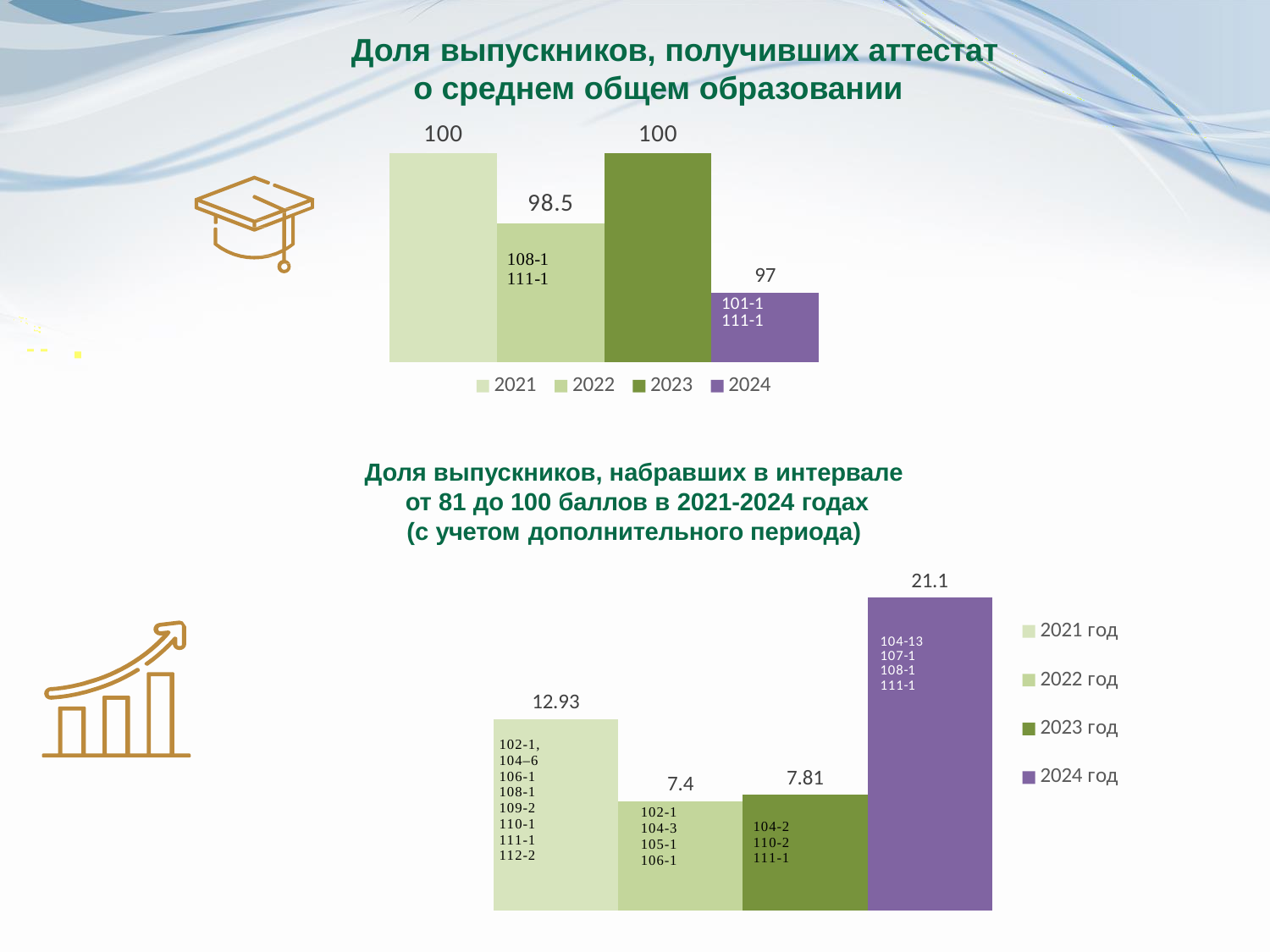
In the top chart, how many series does the legend list? 4 In the bottom chart, which is larger: the value for 2022 год or the value for 2023 год? 2023 год In the top chart, which year has the lowest value? 2024 In the top chart (Доля выпускников, получивших аттестат о среднем общем образовании), what is the value for 2022? 98.5 In the bottom chart, which year has the lowest value? 2022 год In the bottom chart, what is the value for 2024 год? 21.1 In the bottom chart, what is the difference between the 2024 value and the 2021 value? 8.17 In the top chart, what is the difference between the 2021 value and the 2024 value? 3 In the bottom chart (Доля выпускников, набравших в интервале от 81 до 100 баллов), what is the value for 2021 год? 12.93 What type of chart is the top chart? Bar chart In the bottom chart, which year has the highest value? 2024 год In the top chart, what is the value for 2024? 97